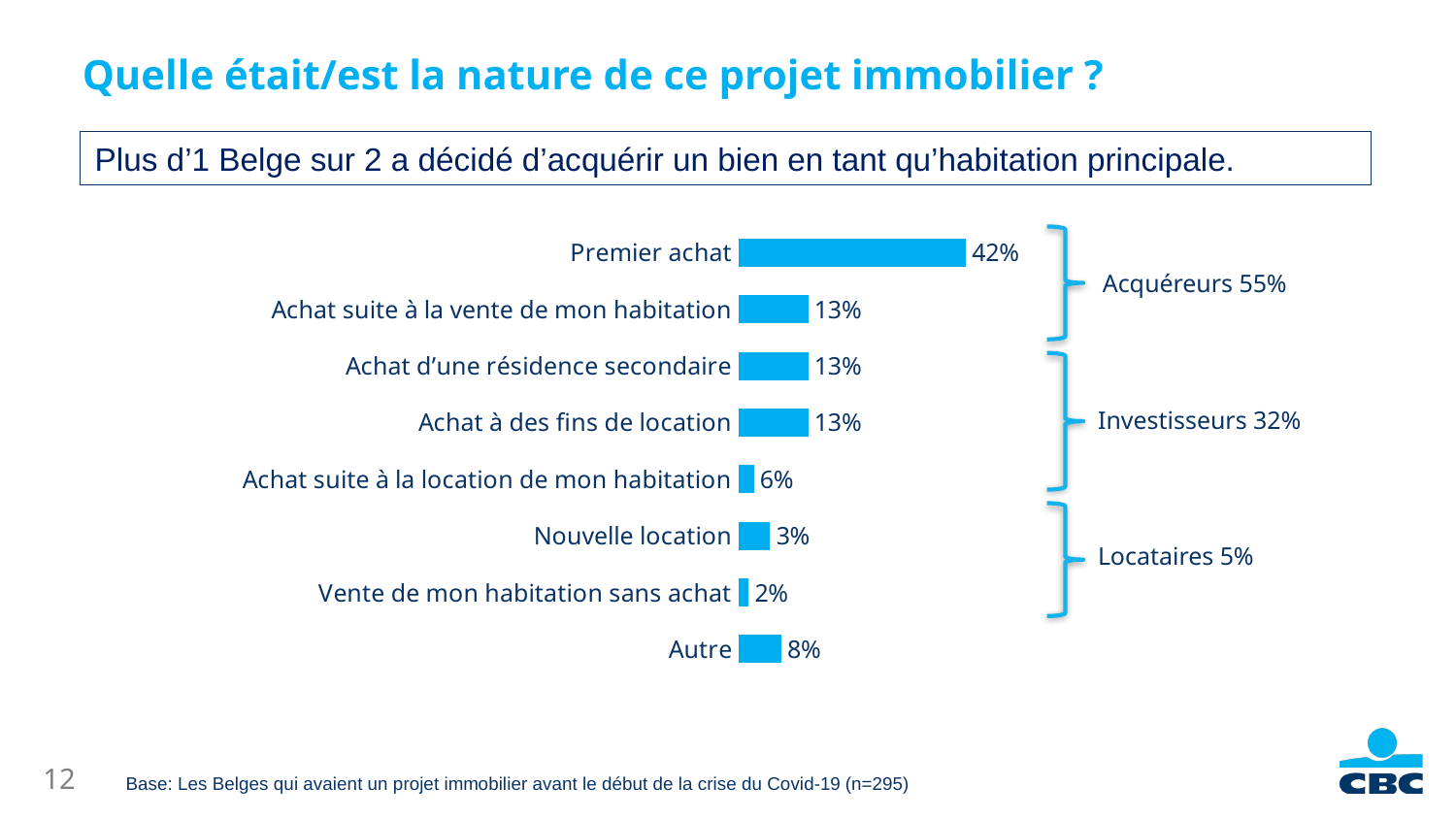
What is the value for "Achat suite à la location de mon habitation"? 6% What percentage is shown for the "Investisseurs" group bracket? 32% What is the value for "Premier achat"? 42% What kind of chart is shown on the slide? Bar chart Which is larger: "Autre" or "Nouvelle location"? Autre Which category has the highest value? Premier achat How many categories are shown in the chart? 8 Which category has the lowest value? Vente de mon habitation sans achat What percentage is shown for the "Acquéreurs" group bracket? 55% What is the value for "Nouvelle location"? 3% What is the value for "Autre"? 8% What is the difference between "Premier achat" and "Achat suite à la vente de mon habitation"? 29%